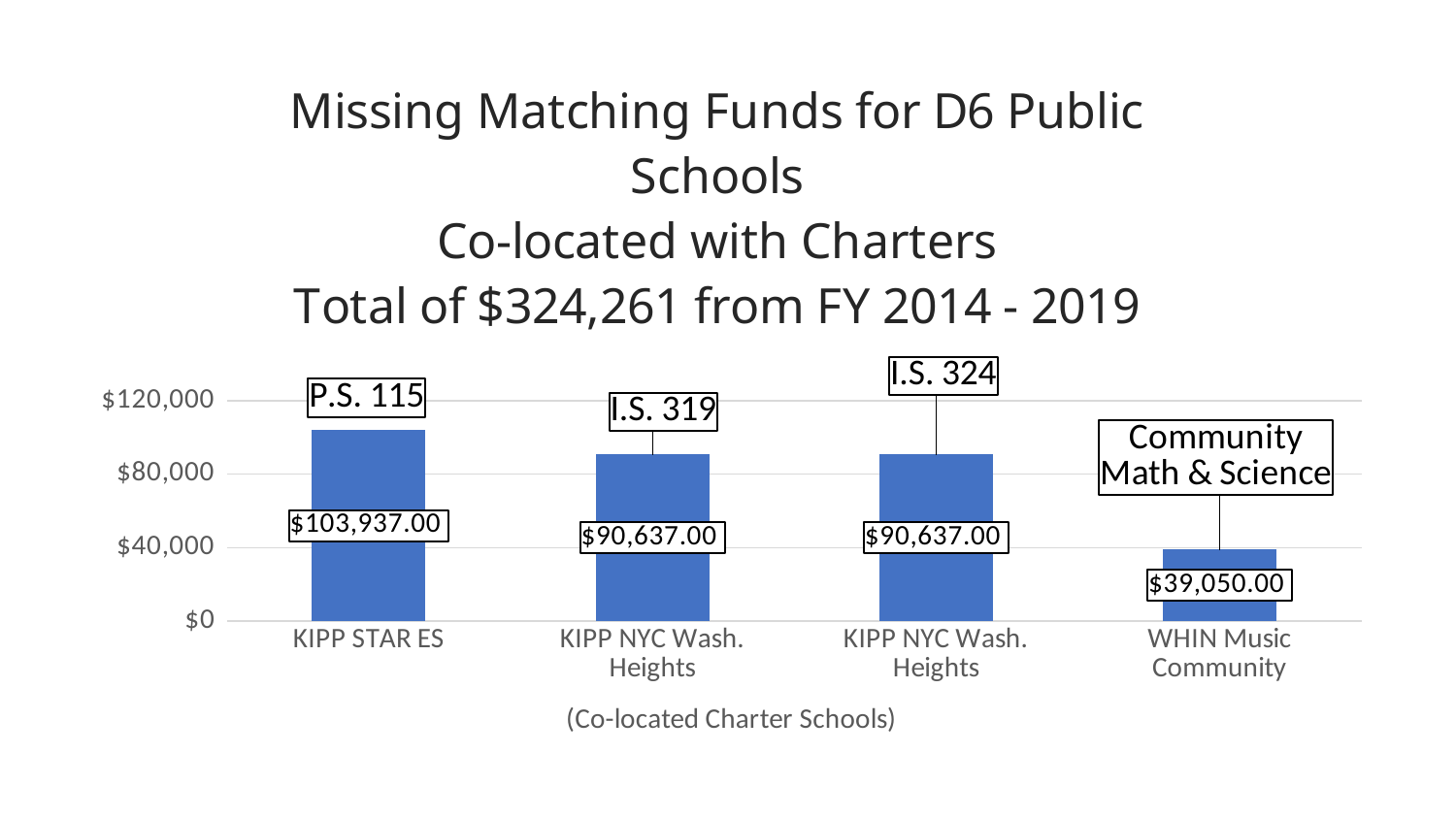
What kind of chart is shown on the slide? bar chart What is the value of the bar labeled I.S. 324? $90,637.00 Which category has the lowest value? WHIN Music Community Is the value for WHIN Music Community greater or less than $80,000? less What is the difference between the values for KIPP STAR ES and WHIN Music Community? $64,887.00 What is the difference between the value for KIPP STAR ES and the bar labeled I.S. 319? $13,300.00 What is the value for WHIN Music Community? $39,050.00 What is the value for KIPP STAR ES? $103,937.00 Which category has the highest value? KIPP STAR ES Which is larger, the value for KIPP STAR ES or the value for WHIN Music Community? KIPP STAR ES Which public school is labeled above the KIPP STAR ES bar? P.S. 115 How many bars are shown in the chart? 4